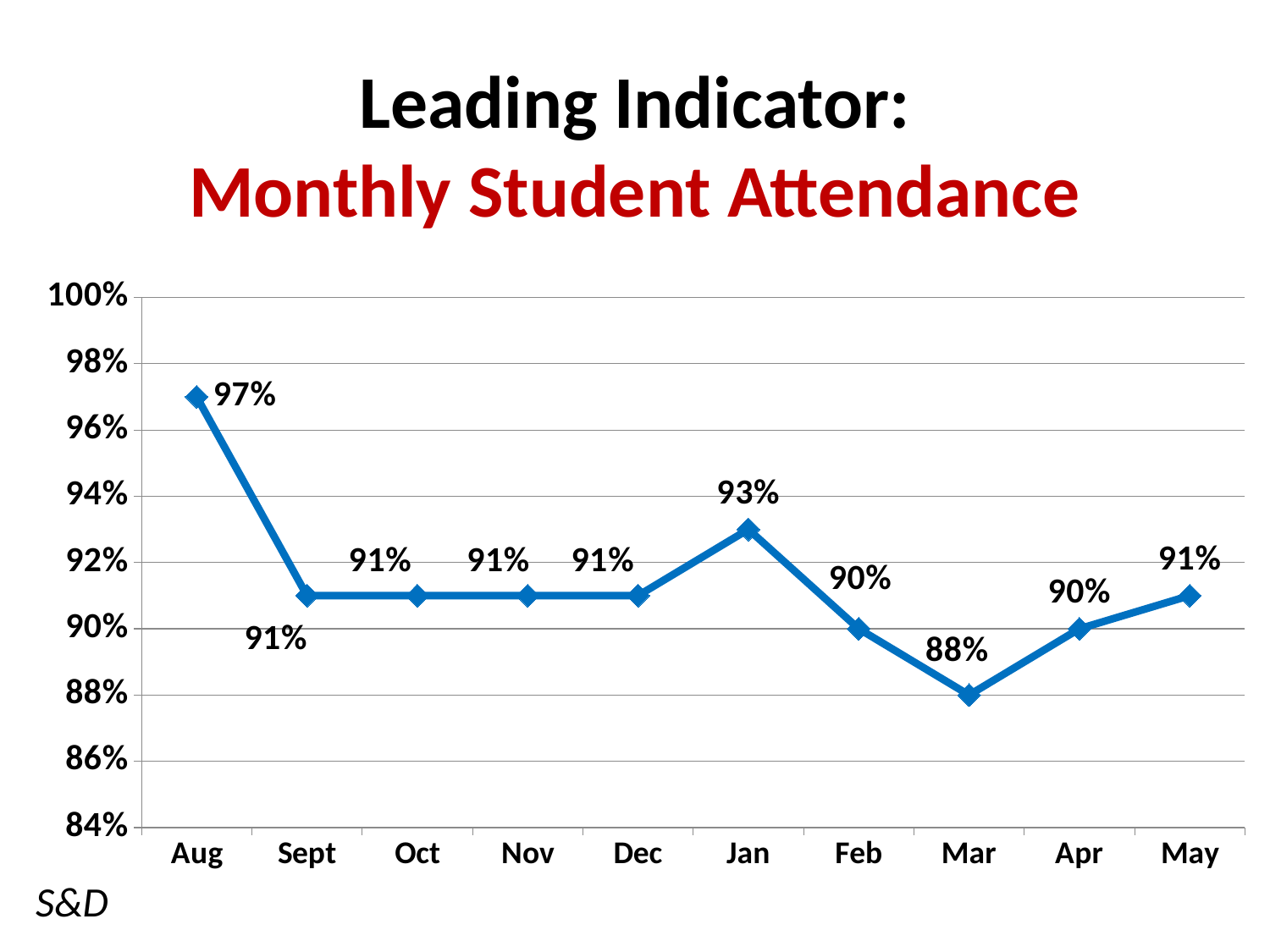
How many months are plotted on the chart? 10 Does attendance rise or fall from Aug to Sept? Fall What is the title of the chart on the slide? Leading Indicator: Monthly Student Attendance Which is larger, the attendance in Jan or the attendance in Feb? Jan What is the attendance value for Feb? 90% What is the attendance value for Jan? 93% Which month has the lowest attendance? Mar Which month has the highest attendance? Aug What is the attendance value for Aug? 97% What is the difference between the attendance in Aug and the attendance in Mar? 9% What kind of chart is shown on the slide? Line chart What is the attendance value for Mar? 88%